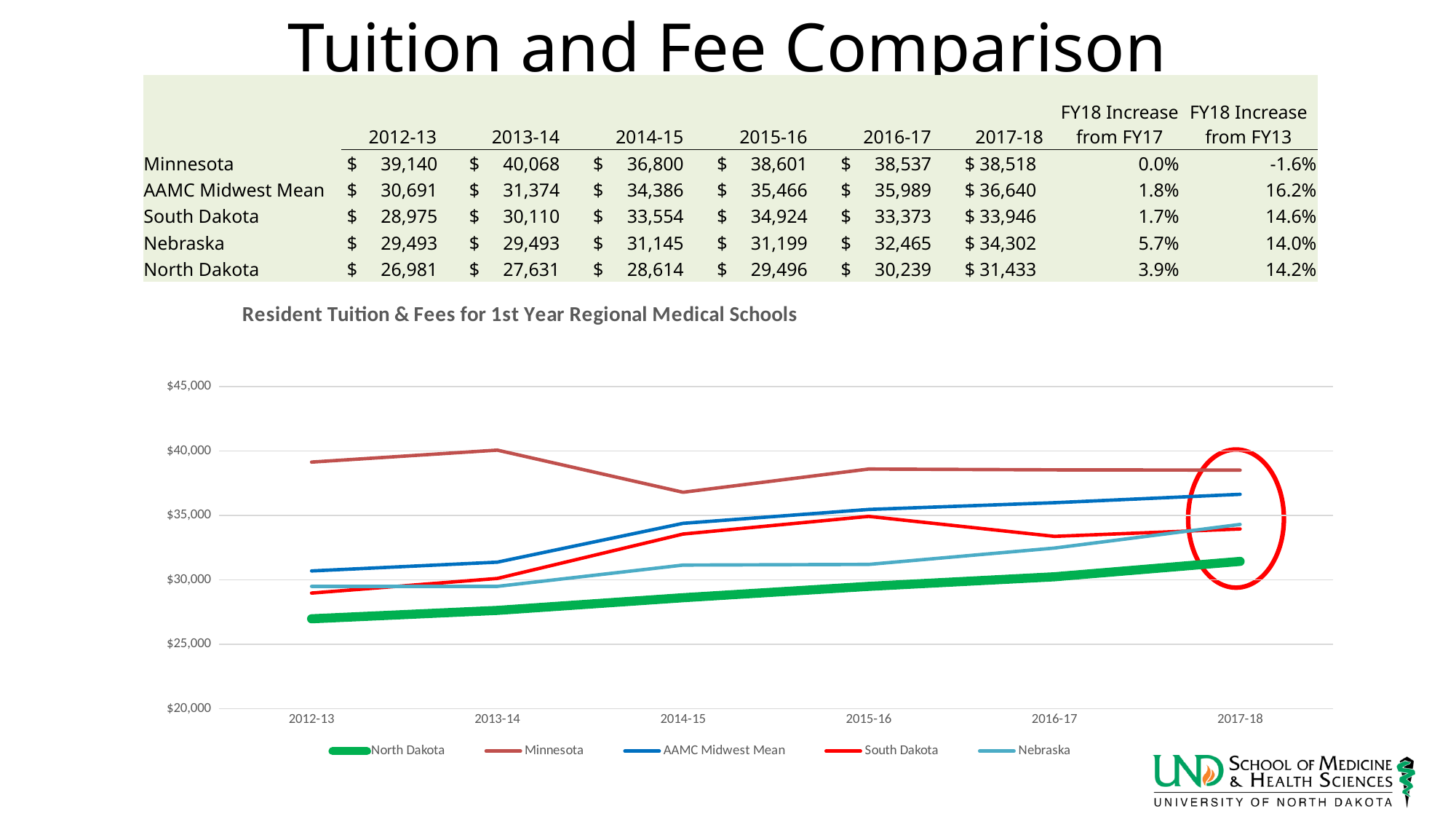
Which school has the lowest resident tuition and fees in 2012-13? North Dakota What is the resident tuition and fees value for Minnesota in 2012-13? $39,140 How many series does the chart legend list? 5 What is the title of the chart? Resident Tuition & Fees for 1st Year Regional Medical Schools Which school has the highest resident tuition and fees in 2017-18? Minnesota What kind of chart is shown on the slide? line chart Is the value for Minnesota in 2014-15 greater or less than $35,000? greater What is the resident tuition and fees value for North Dakota in 2017-18? $31,433 What is the difference between Minnesota and North Dakota resident tuition and fees in 2017-18? $7,085 How many academic years are plotted along the x axis of the chart? 6 Does the North Dakota line rise or fall from 2012-13 to 2017-18? rise Which is larger in 2016-17, the AAMC Midwest Mean or South Dakota? AAMC Midwest Mean